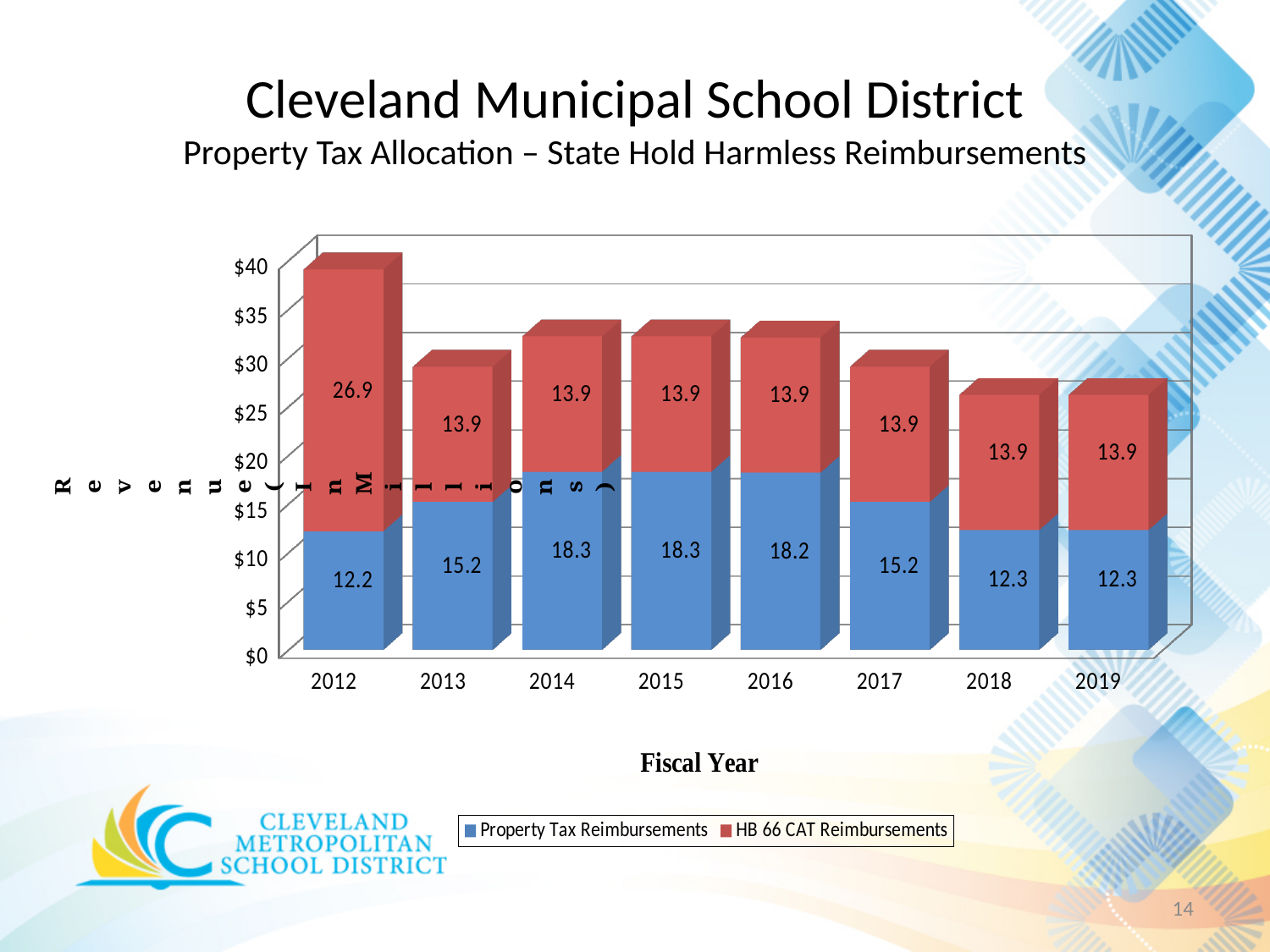
Which is larger in 2017: Property Tax Reimbursements or HB 66 CAT Reimbursements? Property Tax Reimbursements What is the difference between the HB 66 CAT Reimbursements values for 2012 and 2013? 13.0 What is the value of Property Tax Reimbursements for fiscal year 2016? 18.2 In which fiscal year is the Property Tax Reimbursements value lowest? 2012 What is the value of Property Tax Reimbursements for fiscal year 2012? 12.2 What is the value of HB 66 CAT Reimbursements for fiscal year 2019? 13.9 What kind of chart is shown on the slide? Stacked bar chart What is the total of the stacked bar for fiscal year 2014? 32.2 How many fiscal years are shown on the x axis? 8 How many series does the legend list? 2 In which fiscal year is the HB 66 CAT Reimbursements value highest? 2012 What is the value of HB 66 CAT Reimbursements for fiscal year 2012? 26.9